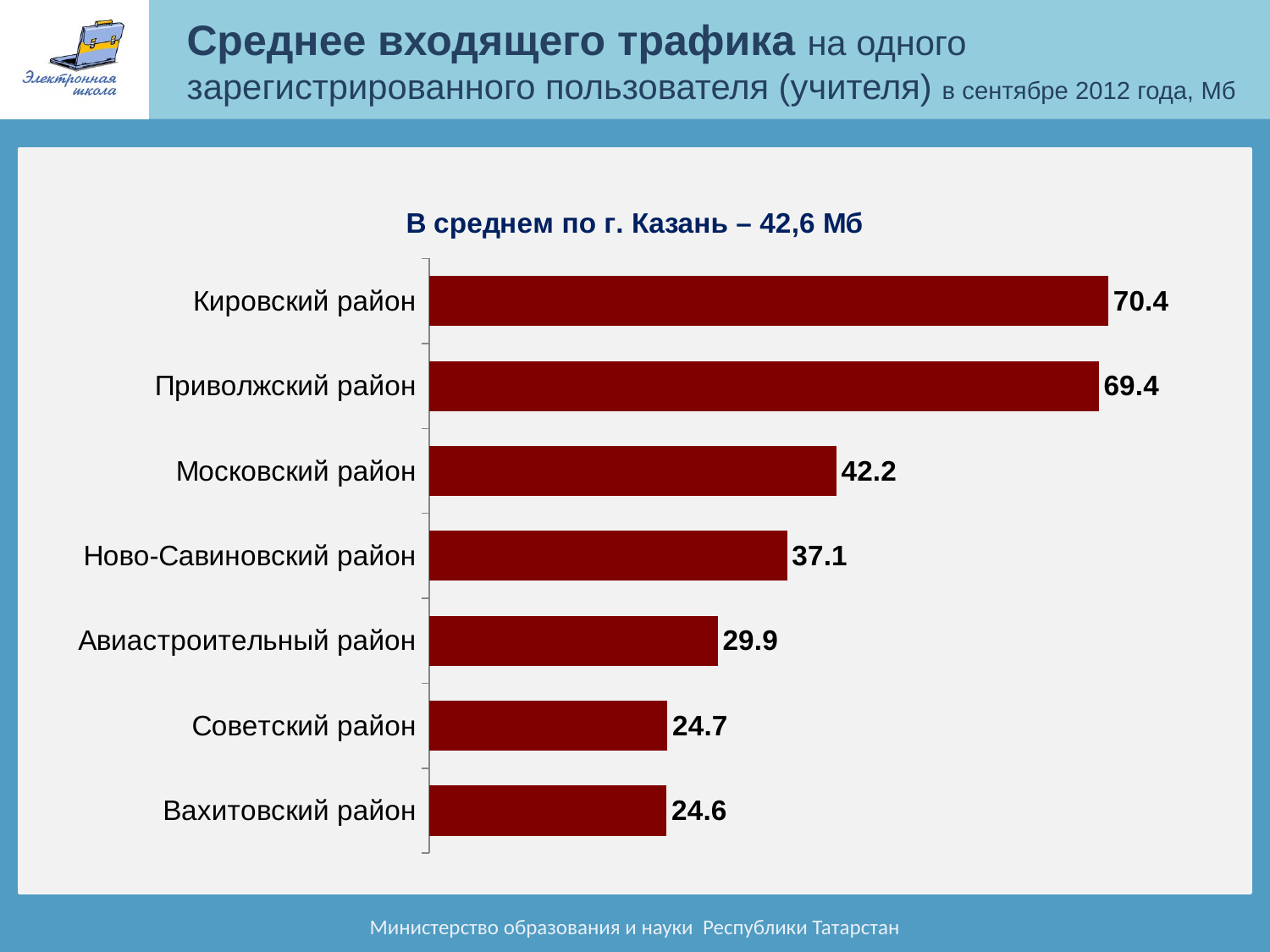
What is the average value for Kazan stated above the chart? 42,6 Мб What kind of chart is shown on the slide? bar chart Which district has the lowest value? Вахитовский район Which district has the highest value? Кировский район How many districts are shown in the chart? 7 What is the value for Авиастроительный район? 29.9 Which is larger, the value for Ново-Савиновский район or Авиастроительный район? Ново-Савиновский район What is the difference between the values for Московский район and Ново-Савиновский район? 5.1 What is the value for Кировский район? 70.4 What is the value for Московский район? 42.2 What colour are the bars in the chart? dark red What is the difference between the values for Кировский район and Приволжский район? 1.0